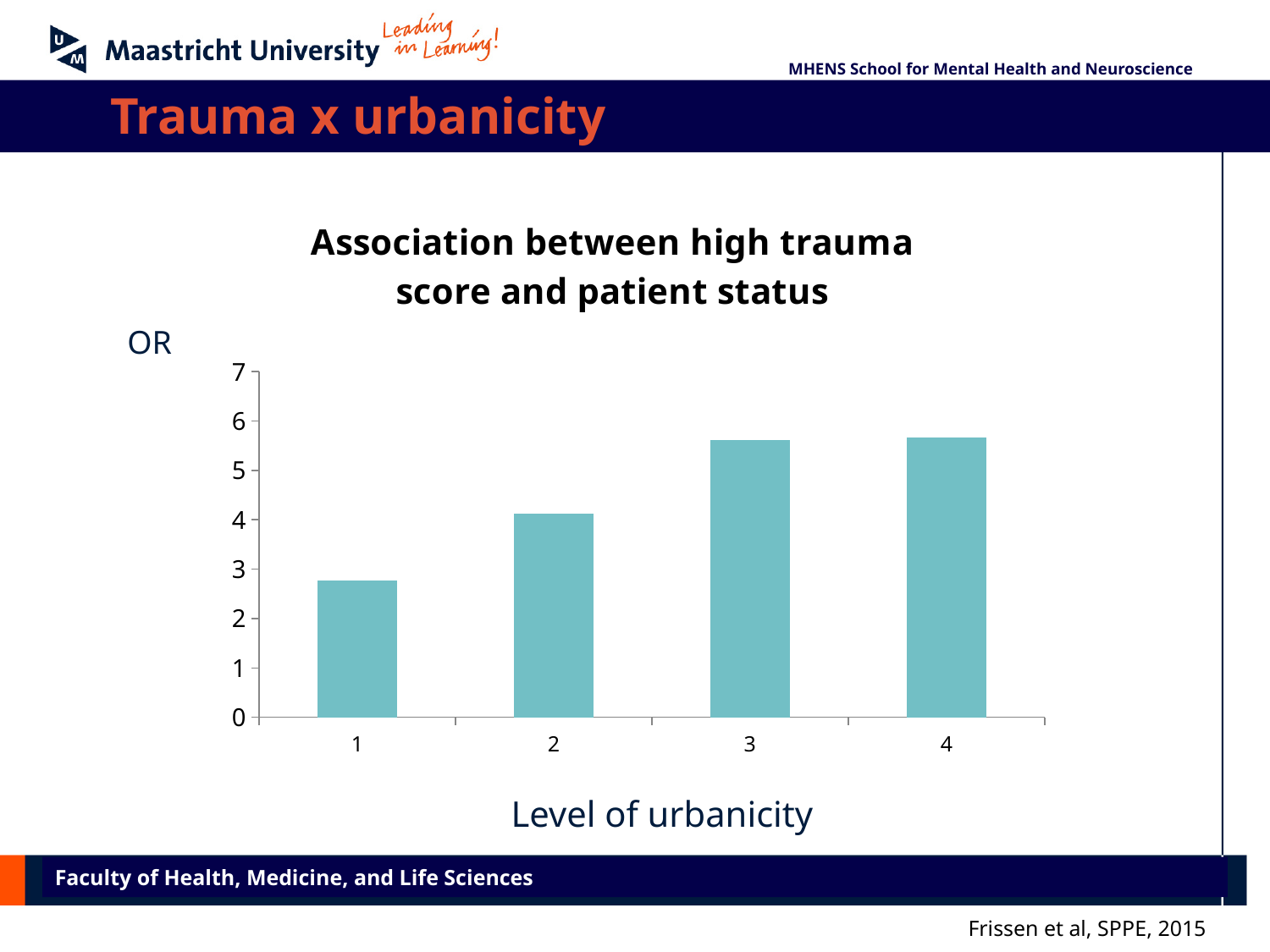
Which has the larger OR, urbanicity level 2 or level 4? 4 Does the OR generally rise or fall as the level of urbanicity increases from 1 to 4? rise Is the OR for urbanicity level 1 greater or less than 2? greater What is the title of the chart? Association between high trauma score and patient status Is the OR for urbanicity level 4 greater or less than 6? less Is the OR for urbanicity level 3 greater or less than 5? greater Which has the larger OR, urbanicity level 1 or level 3? 3 What kind of chart is shown on the slide? bar chart Which level of urbanicity has the lowest OR? 1 How many levels of urbanicity are plotted on the x axis? 4